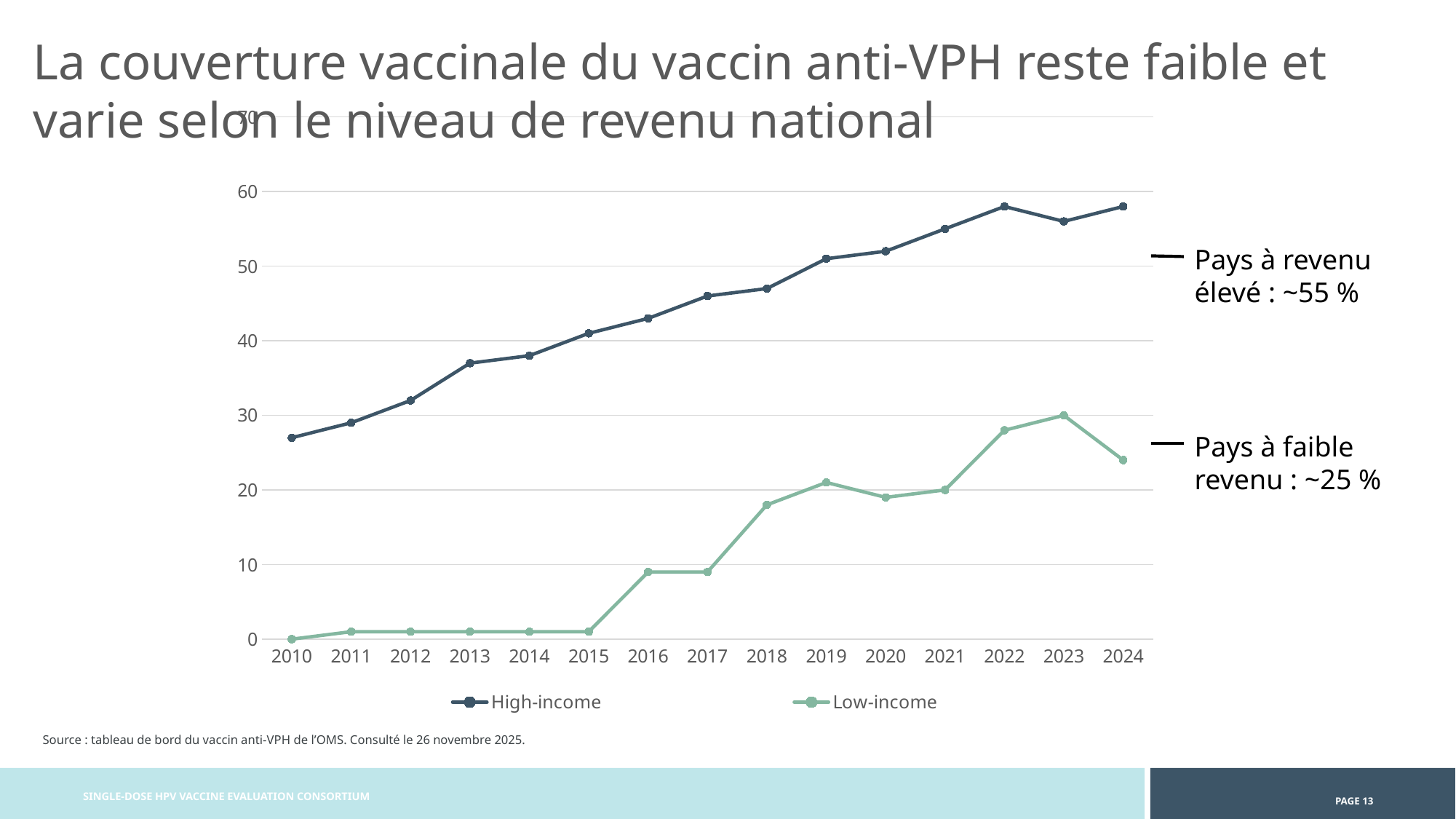
In 2024, which series has the larger value, High-income or Low-income? High-income Which year has the highest value for the Low-income series? 2023 Is the value for High-income in 2010 greater or less than 30? less Which year has the lowest value for the High-income series? 2010 Is the value for Low-income in 2022 greater or less than 20? greater What are the two series names listed in the legend? High-income and Low-income Does the High-income series generally rise or fall from 2010 to 2024? rise How many series does the legend list? 2 How many years are shown on the x axis? 15 What kind of chart is shown on the slide? line chart Is the value for High-income in 2024 greater or less than 50? greater